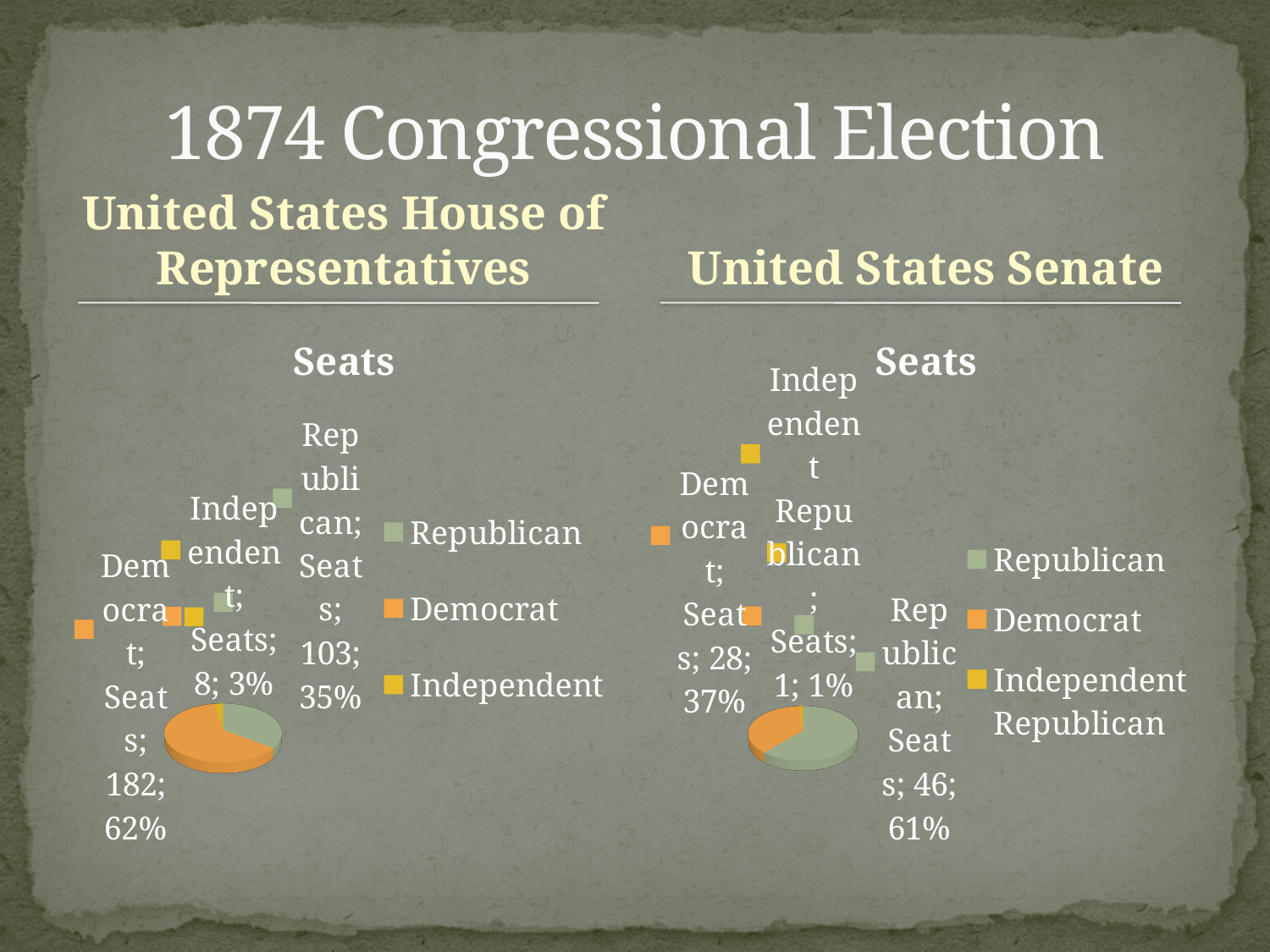
What kind of chart is used for the United States Senate seats? Pie chart In the United States Senate chart, what share of seats did the Democrats hold? 37% How many entries does the legend of the United States Senate chart list? 3 In the United States Senate chart, how many seats did the Republicans win? 46 In the United States Senate chart, which party has the smallest slice? Independent Republican In the United States House of Representatives chart, what share of seats did the Republicans hold? 35% In the United States House of Representatives chart, how many seats did the Democrats win? 182 In the United States House of Representatives chart, how many seats are labelled for Independent? 8 In the United States House of Representatives chart, which party has the largest slice? Democrat In the United States Senate chart, which is larger, the Democrat seats or the Republican seats? Republican In the United States House of Representatives chart, what is the difference in seats between Democrat and Republican? 79 In the United States Senate chart, what is the difference in seats between Republican and Democrat? 18